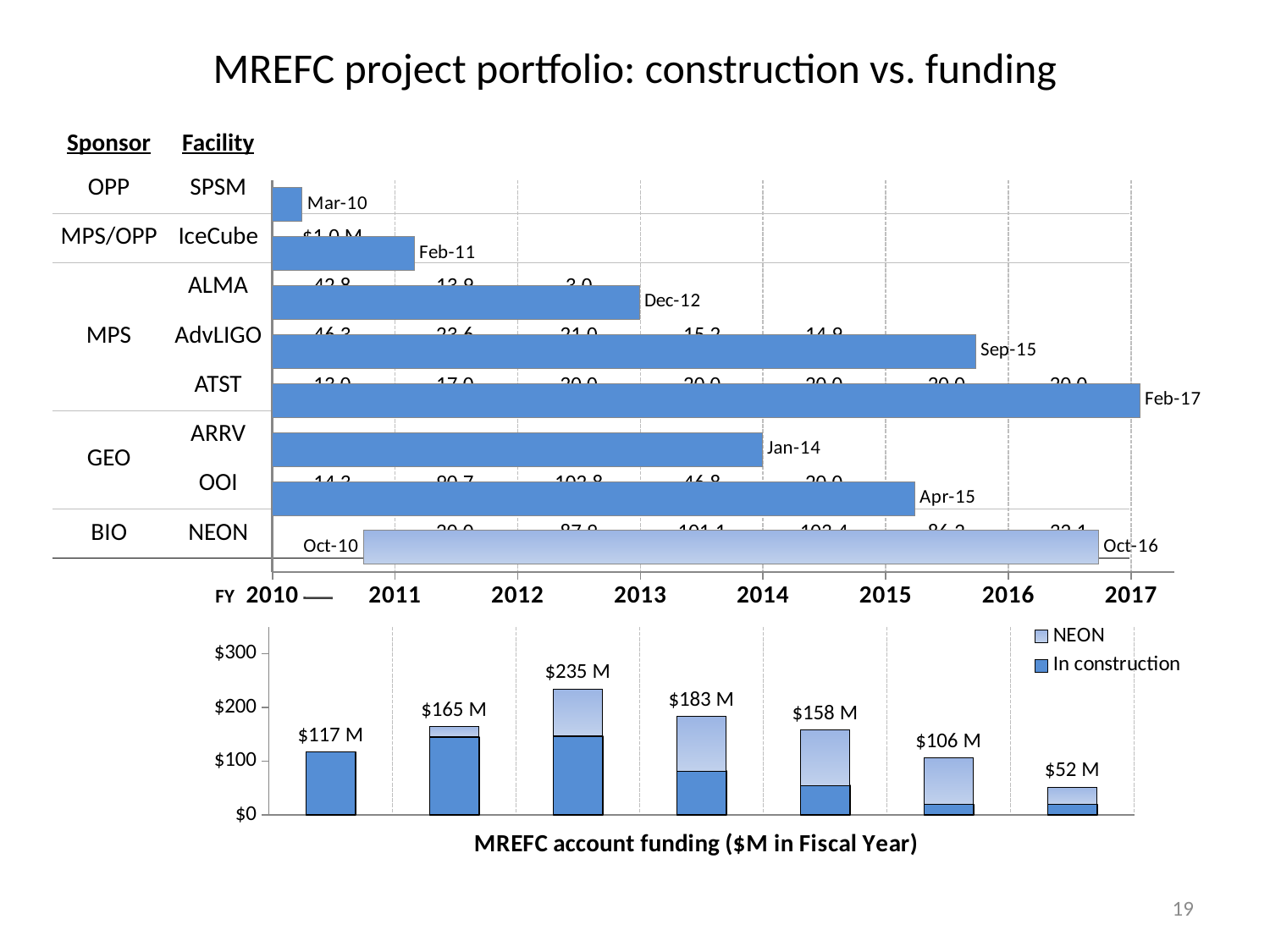
In the top chart (construction timeline), what end date is labeled for the ATST bar? Feb-17 What kind of chart is the bottom chart (MREFC account funding)? Stacked bar chart In the bottom chart (MREFC account funding), what is the difference between the total funding in 2012 and in 2013? $52 M In the bottom chart (MREFC account funding), what is the total funding labeled for fiscal year 2012? $235 M In the bottom chart (MREFC account funding), do the total values rise or fall from 2012 to 2016? Fall In the bottom chart (MREFC account funding), how many series does the legend list? 2 In the bottom chart (MREFC account funding), what are the two legend entries? NEON and In construction In the bottom chart (MREFC account funding), which fiscal year has the highest total funding? 2012 In the bottom chart (MREFC account funding), how many fiscal years are plotted? 7 In the bottom chart (MREFC account funding), which fiscal year has larger total funding, 2011 or 2014? 2011 In the bottom chart (MREFC account funding), which fiscal year has the lowest total funding? 2016 In the top chart (construction timeline), what start date is labeled for the NEON bar? Oct-10